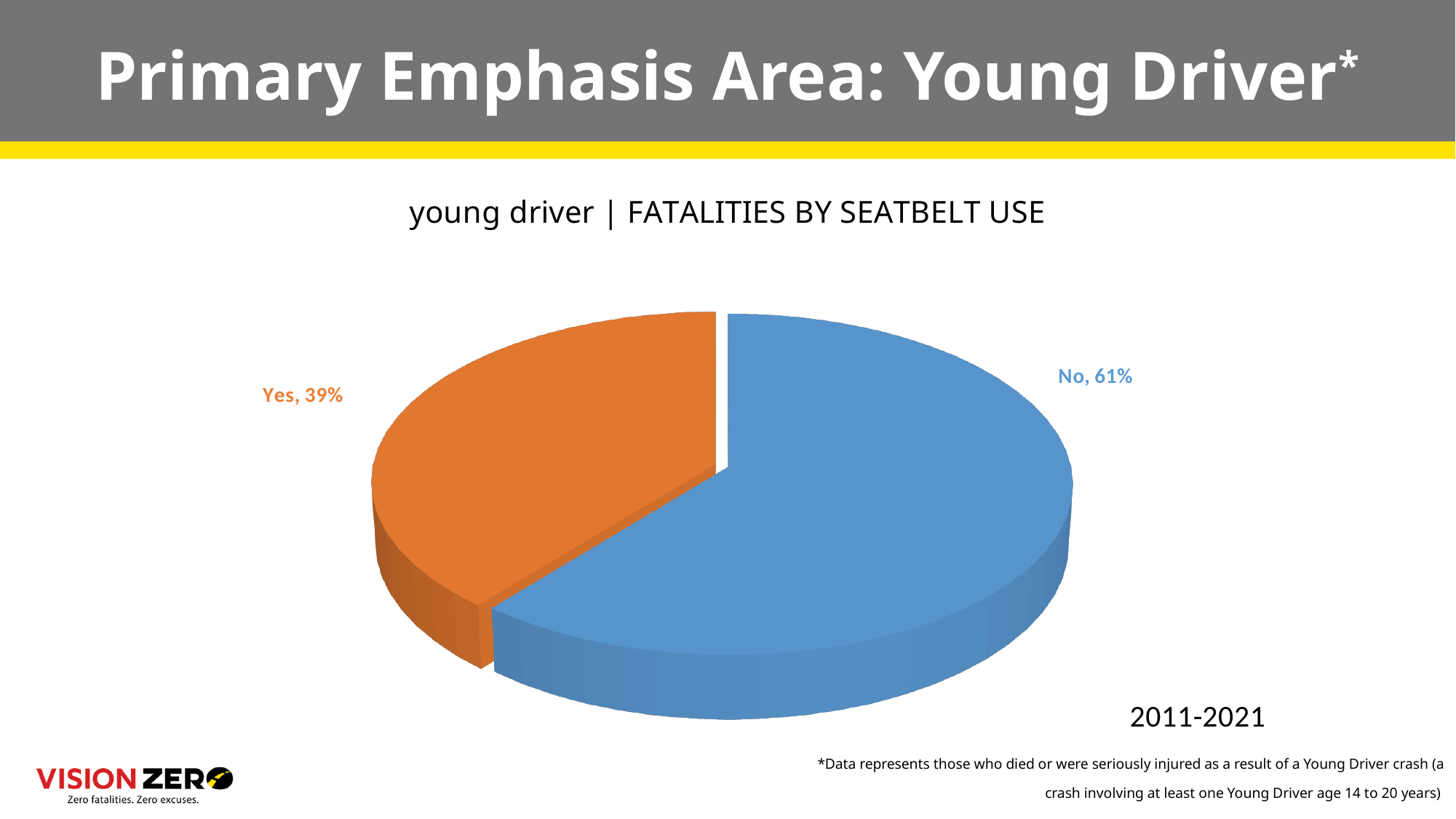
How many slices does the pie chart have? 2 What colour is the "Yes" slice of the pie? Orange What is the title of the chart? young driver | FATALITIES BY SEATBELT USE Which is larger, the "Yes" slice or the "No" slice? No What share of young driver fatalities had seatbelt use marked "Yes"? 39% Which category has the smallest slice of the pie? Yes What kind of chart is shown on the slide? Pie chart What share of young driver fatalities had seatbelt use marked "No"? 61% What time period does the chart cover? 2011-2021 Which category has the largest slice of the pie? No What is the difference in percentage points between the "No" and "Yes" slices? 22